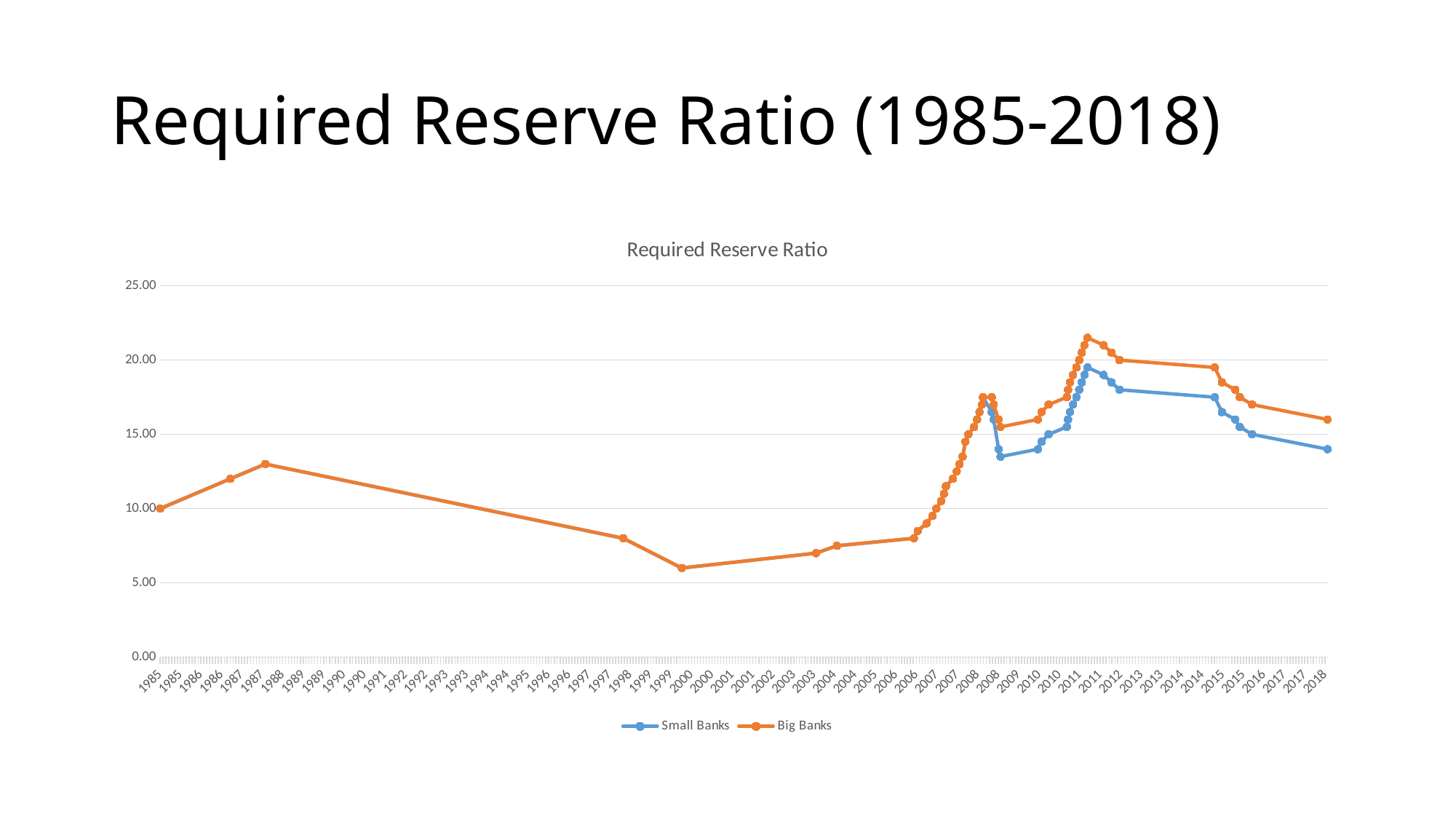
Is the Big Banks value in 2000 greater or less than 10.00? less Which series reaches the highest value on the chart? Big Banks How many series does the legend list? 2 Between 1987 and 2000, does the Big Banks line rise or fall? fall What are the two series named in the legend? Small Banks and Big Banks What kind of chart is shown on the slide? line chart What is the title printed above the chart? Required Reserve Ratio Is the Small Banks value in 2018 greater or less than 15.00? less In 2018, which series has the higher value, Small Banks or Big Banks? Big Banks Is the peak Big Banks value around 2011 greater or less than 20.00? greater